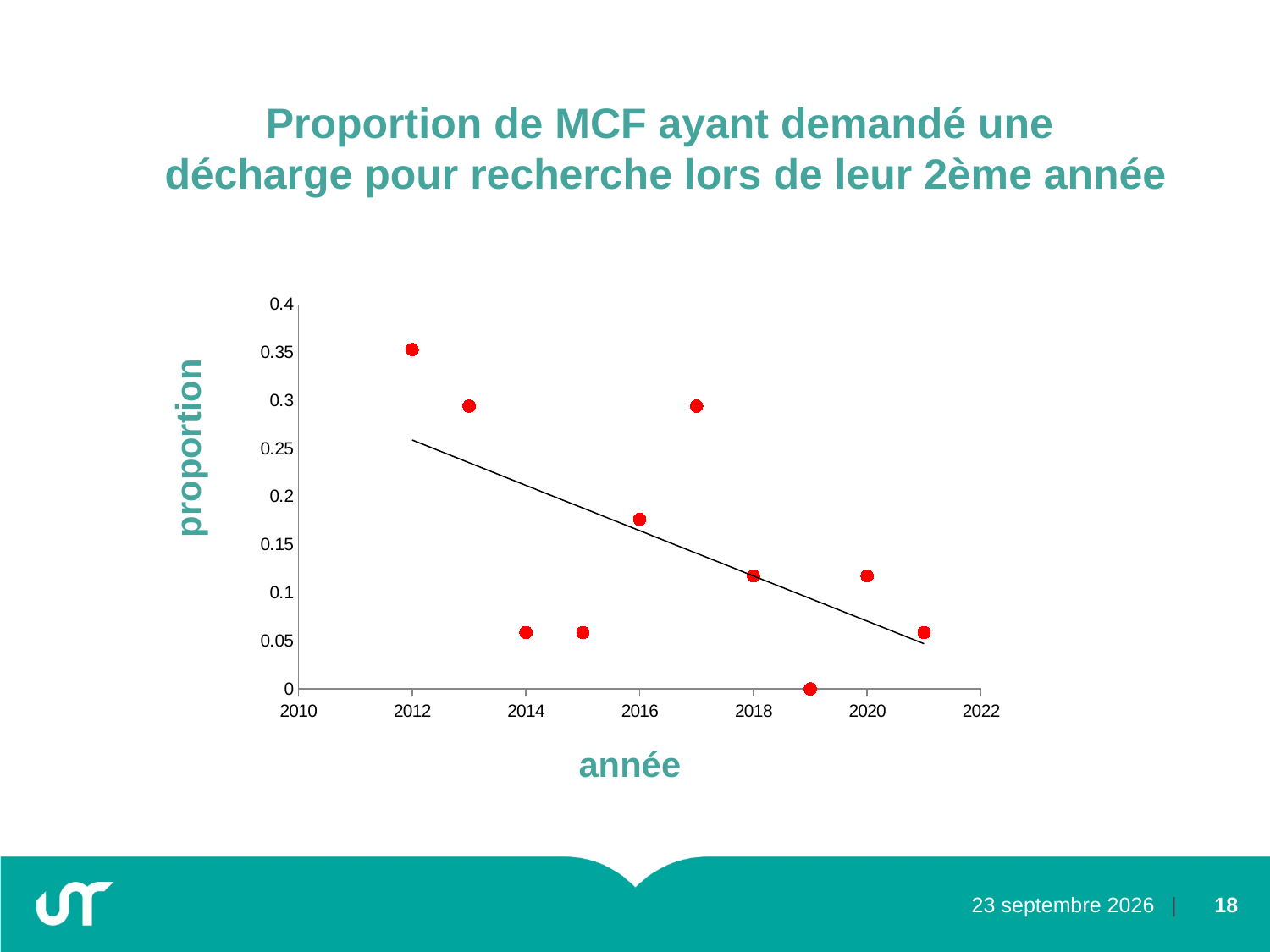
Which year has the lowest proportion? 2019 What is the label of the x axis? année What is the proportion for 2019? 0 Is the proportion for 2014 greater or less than 0.1? less Is the proportion for 2021 greater or less than 0.1? less Does the trend line show the proportion rising or falling over the years? falling Is the proportion for 2012 greater or less than 0.3? greater How many data points are plotted on the chart? 10 What kind of chart is shown on the slide? scatter plot Which year has a higher proportion, 2013 or 2016? 2013 Which year has the highest proportion? 2012